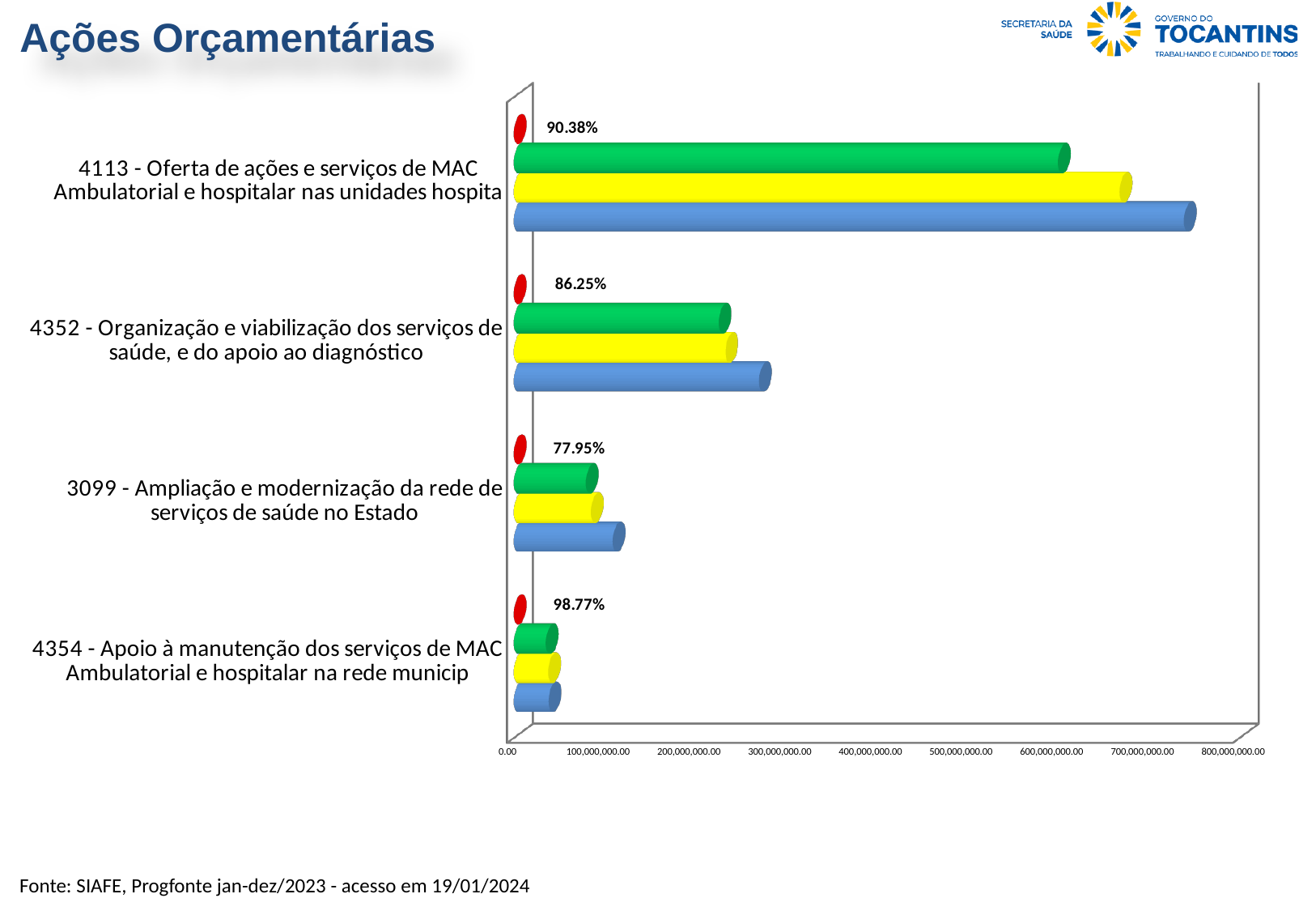
What percentage is shown for the category "4113 - Oferta de ações e serviços de MAC Ambulatorial e hospitalar nas unidades hospita"? 90.38% What is the difference in percentage points between the labels for category 4354 and category 3099? 20.82 Which category has the highest percentage label? 4354 - Apoio à manutenção dos serviços de MAC Ambulatorial e hospitalar na rede municip Which has the larger percentage label, category 4113 or category 4352? 4113 How many categories are shown on the chart? 4 Is the value of the blue bar for category 4352 greater or less than 300,000,000.00? less What type of chart is shown on the slide? Bar chart What percentage is shown for the category "4352 - Organização e viabilização dos serviços de saúde, e do apoio ao diagnóstico"? 86.25% Is the value of the blue bar for category 4113 greater or less than 700,000,000.00? greater What percentage is shown for the category "3099 - Ampliação e modernização da rede de serviços de saúde no Estado"? 77.95% What percentage is shown for the category "4354 - Apoio à manutenção dos serviços de MAC Ambulatorial e hospitalar na rede municip"? 98.77% Which category has the lowest percentage label? 3099 - Ampliação e modernização da rede de serviços de saúde no Estado